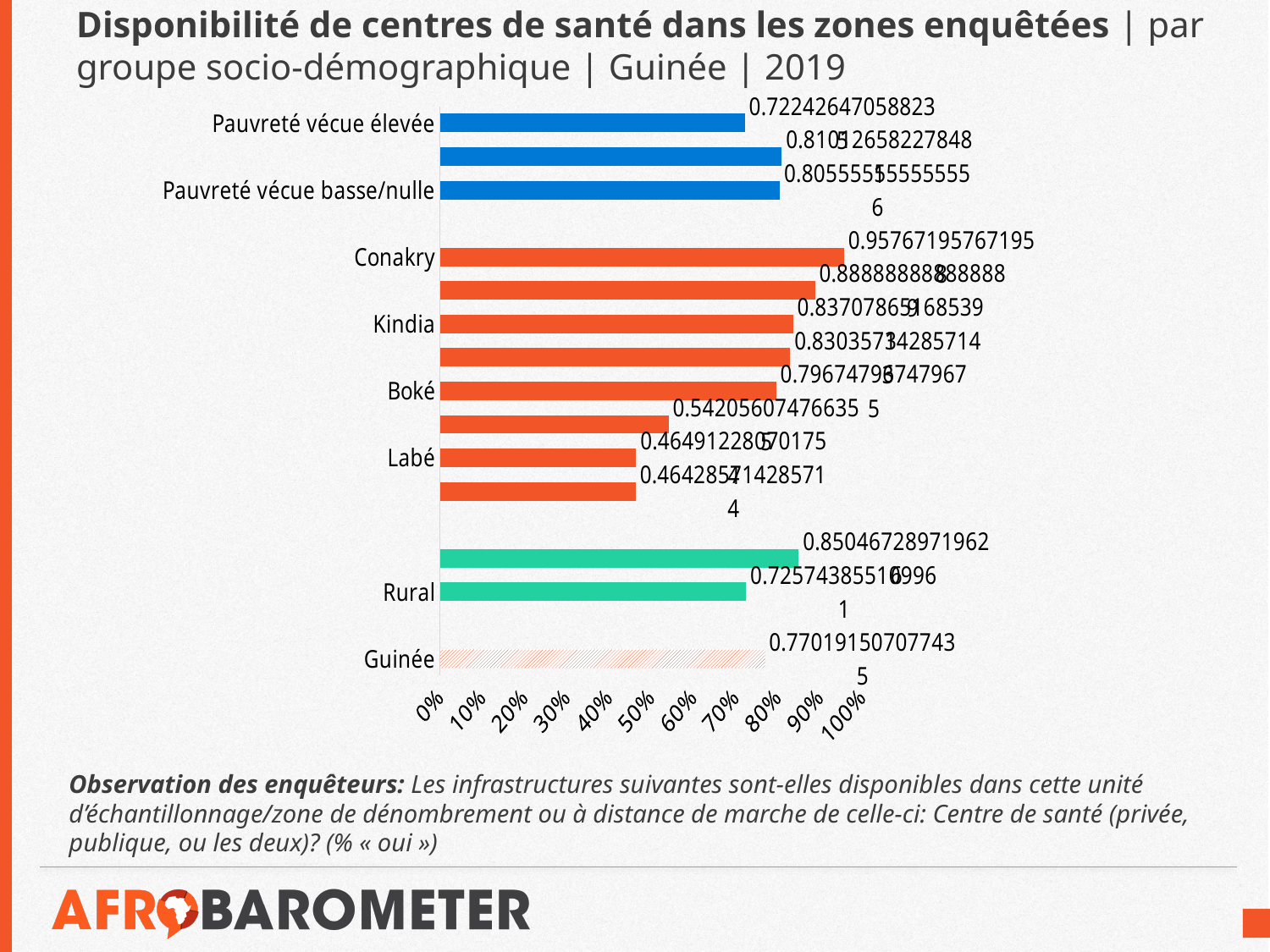
How many bars are plotted in the chart? 14 Is the value for Conakry greater or less than 90%? greater What is the data label value for Pauvreté vécue élevée? 0.72242647058823 What colour are the bars for Conakry, Kindia, Boké and Labé? orange Is the value for Guinée greater or less than 70%? greater What kind of chart is shown on the slide? bar chart Which labeled category has the highest value? Conakry What is the data label value for Conakry? 0.95767195767195 Which is larger, the value for Conakry or for Labé? Conakry Which labeled category has the lowest value? Labé Is the value for Labé greater or less than 50%? less Which is larger, the value for Pauvreté vécue basse/nulle or for Pauvreté vécue élevée? Pauvreté vécue basse/nulle